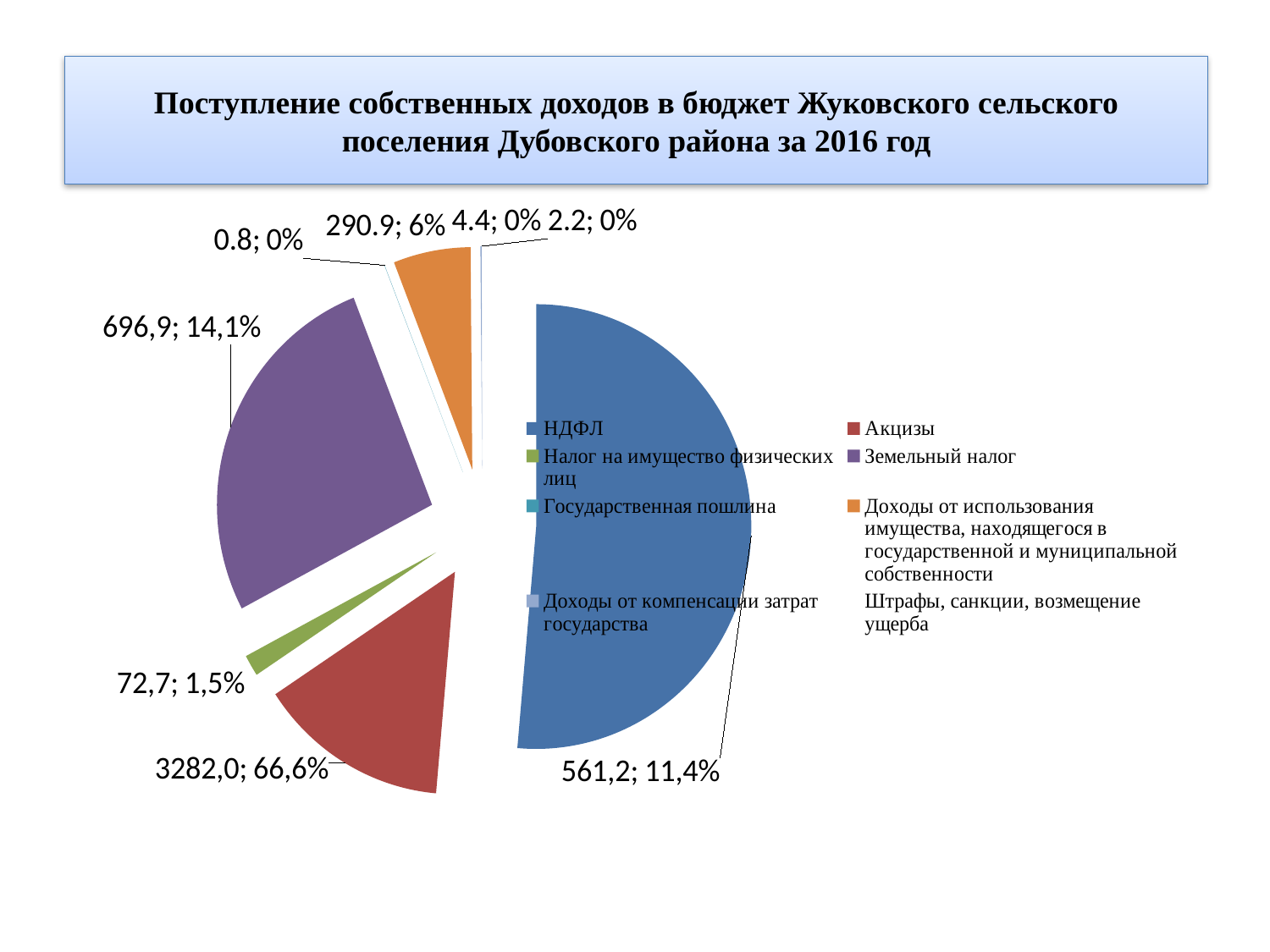
What is the share of the purple slice (Земельный налог) in the pie chart? 14,1% What is the share of the orange slice (Доходы от использования имущества, находящегося в государственной и муниципальной собственности)? 6% Which is larger, the Земельный налог slice or the Налог на имущество физических лиц slice? Земельный налог What is the difference between the values printed for the Земельный налог slice (696,9) and the Налог на имущество физических лиц slice (72,7)? 624,2 What kind of chart is shown on the slide? pie chart What value is printed for the Налог на имущество физических лиц slice? 72,7 How many categories does the legend of the pie chart list? 8 What is the share of the green slice (Налог на имущество физических лиц)? 1,5% What value is printed for the Земельный налог slice? 696,9 Which legend entry is shown in blue in the pie chart? НДФЛ